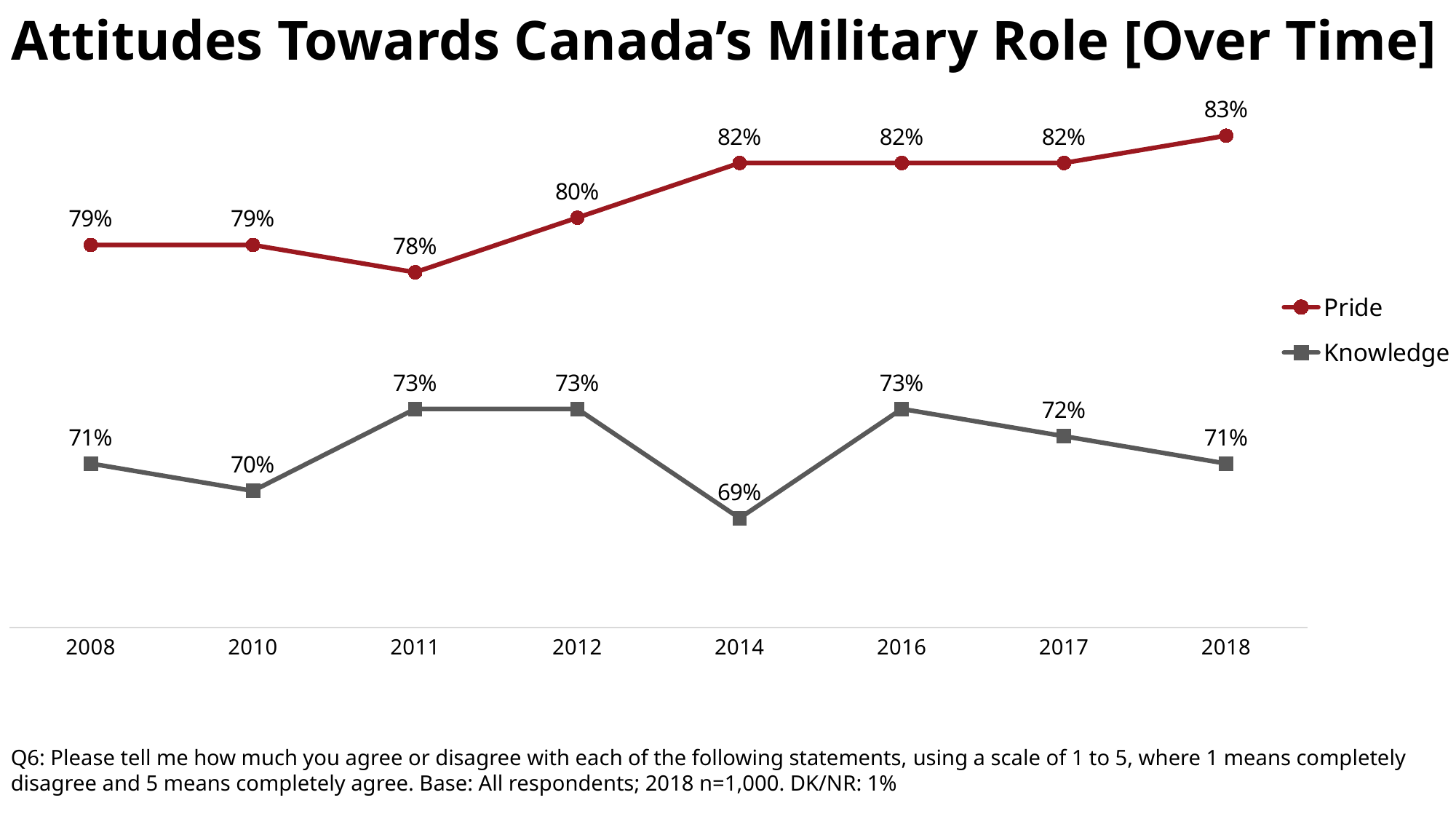
In which year is the Knowledge value lowest? 2014 What is the difference between the Pride and Knowledge values in 2018? 12% Which is larger in 2012, the Pride value or the Knowledge value? Pride How many series does the legend list? 2 What kind of chart is shown on the slide? Line chart What is the Pride value for 2011? 78% Does the Pride series rise or fall from 2011 to 2018? Rise What is the Knowledge value for 2014? 69% In which year is the Pride value highest? 2018 What is the Knowledge value for 2017? 72% What is the Pride value for 2018? 83% How many years are shown on the x axis? 8